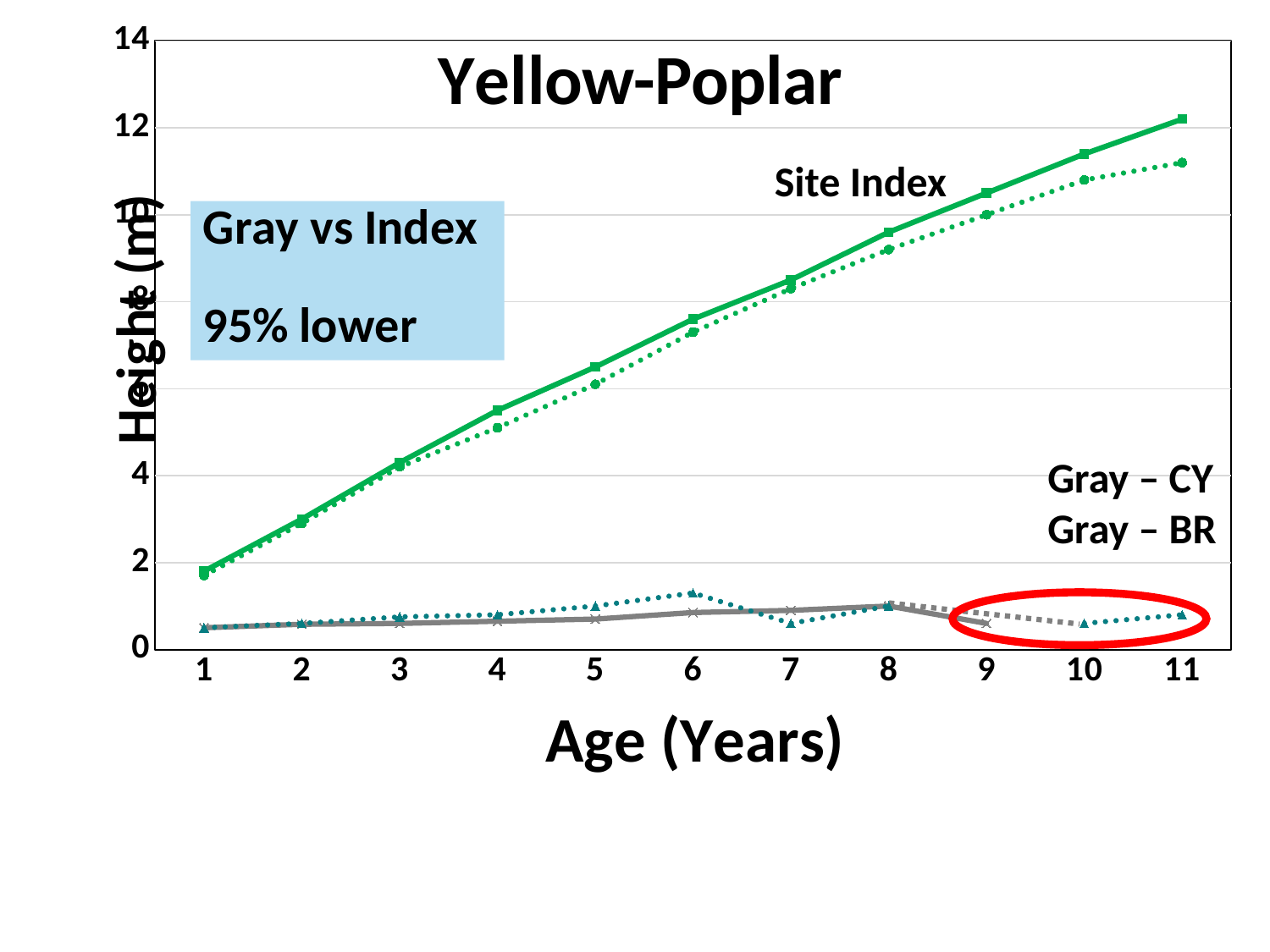
Is the solid Site Index height at age 8 greater or less than 8? greater What kind of chart is shown on the slide? Line chart What is the label of the x axis? Age (Years) Is the Site Index height at age 1 greater or less than 2? less Is the Gray – CY height at age 11 greater or less than 2? less What is the title of the chart? Yellow-Poplar At age 6, which is higher: the Site Index line or the Gray – CY line? Site Index How many age values are plotted along the x axis? 11 Does the Site Index height rise or fall as age increases from 1 to 11 years? Rises